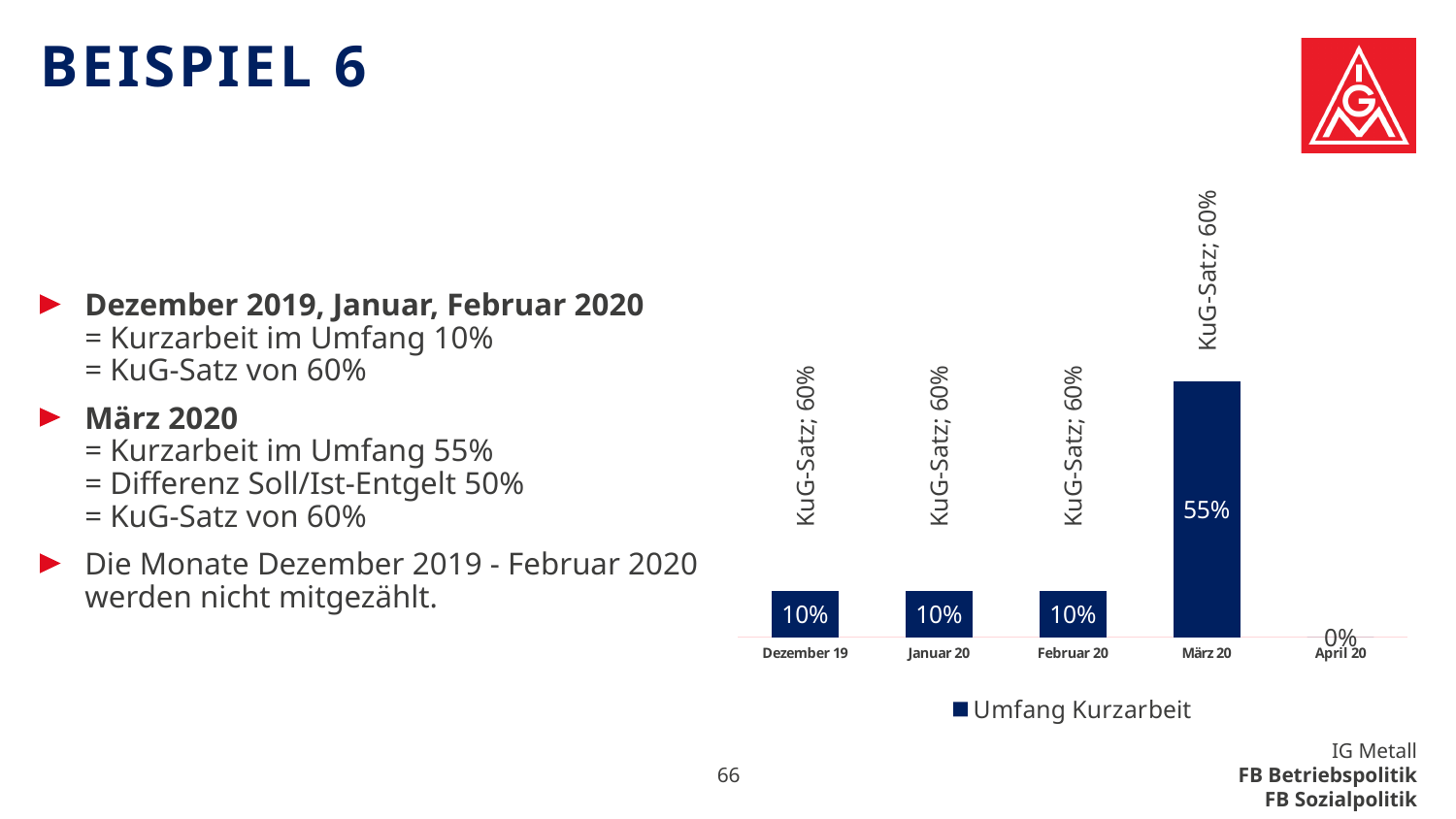
What is the value for Dezember 19 in the chart? 10% What is the value for März 20 in the chart? 55% What kind of chart is shown on the slide? bar chart How many series does the chart legend list? 1 What is the difference between the values for März 20 and Februar 20? 45% How many months are shown on the x axis of the chart? 5 What KuG-Satz is printed above the bar for März 20? 60% What series name is shown in the chart legend? Umfang Kurzarbeit Which is larger, the value for Januar 20 or the value for März 20? März 20 Which month has the highest value in the chart? März 20 Which month has the lowest value in the chart? April 20 What is the value for April 20 in the chart? 0%